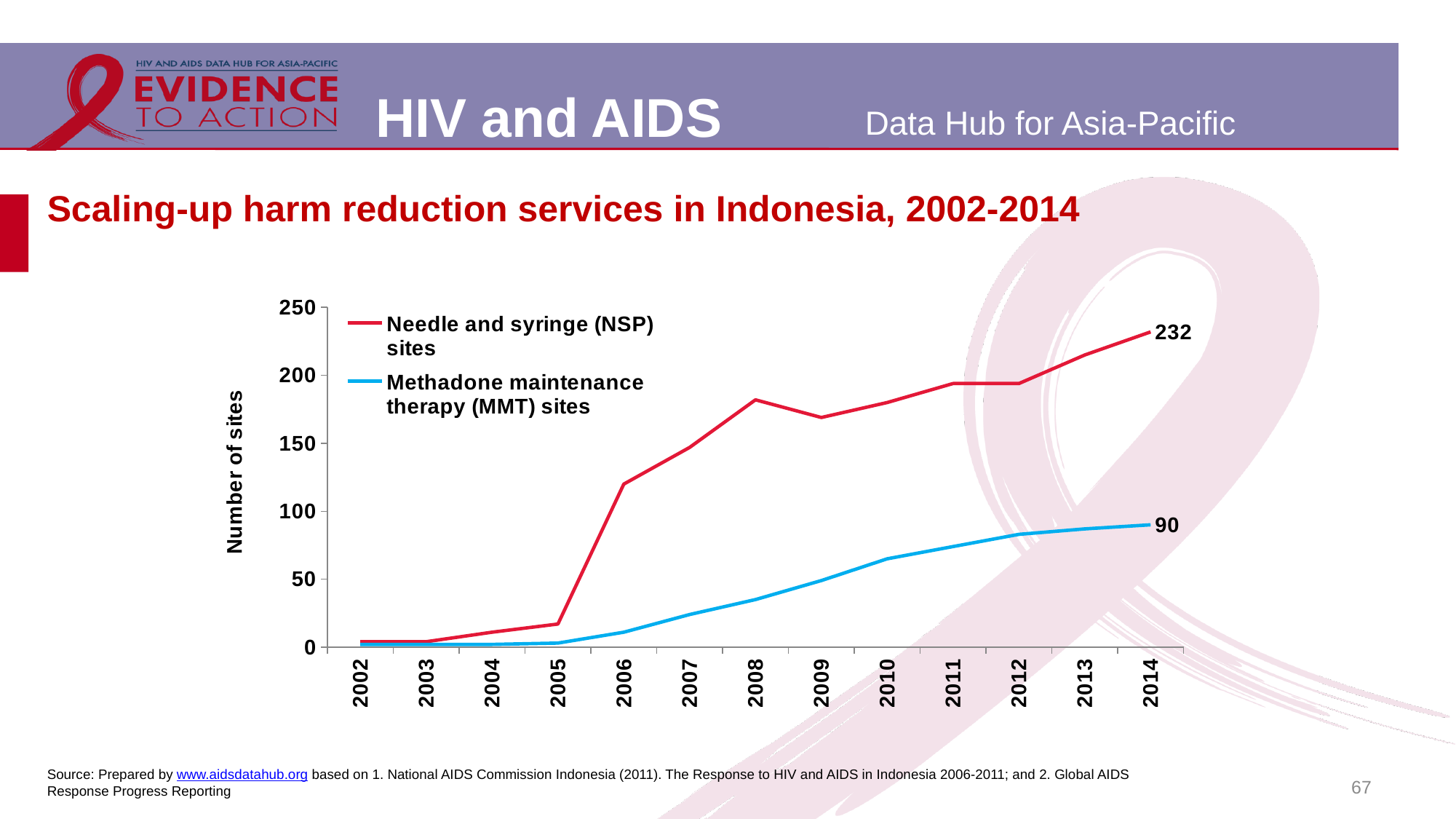
What kind of chart is shown on the slide? line chart In which year is the number of Needle and syringe (NSP) sites highest? 2014 Do the Methadone maintenance therapy (MMT) sites rise or fall from 2002 to 2014? rise What is the label of the y axis? Number of sites Is the number of NSP sites in 2008 greater or less than 150? greater How many years are shown on the x axis? 13 Is the number of MMT sites in 2008 greater or less than 50? less What is the number of Methadone maintenance therapy (MMT) sites in 2014? 90 What is the number of Needle and syringe (NSP) sites in 2014? 232 In 2014, which series has the larger value, NSP sites or MMT sites? NSP sites In 2014, how many more NSP sites are there than MMT sites? 142 How many series does the legend list? 2